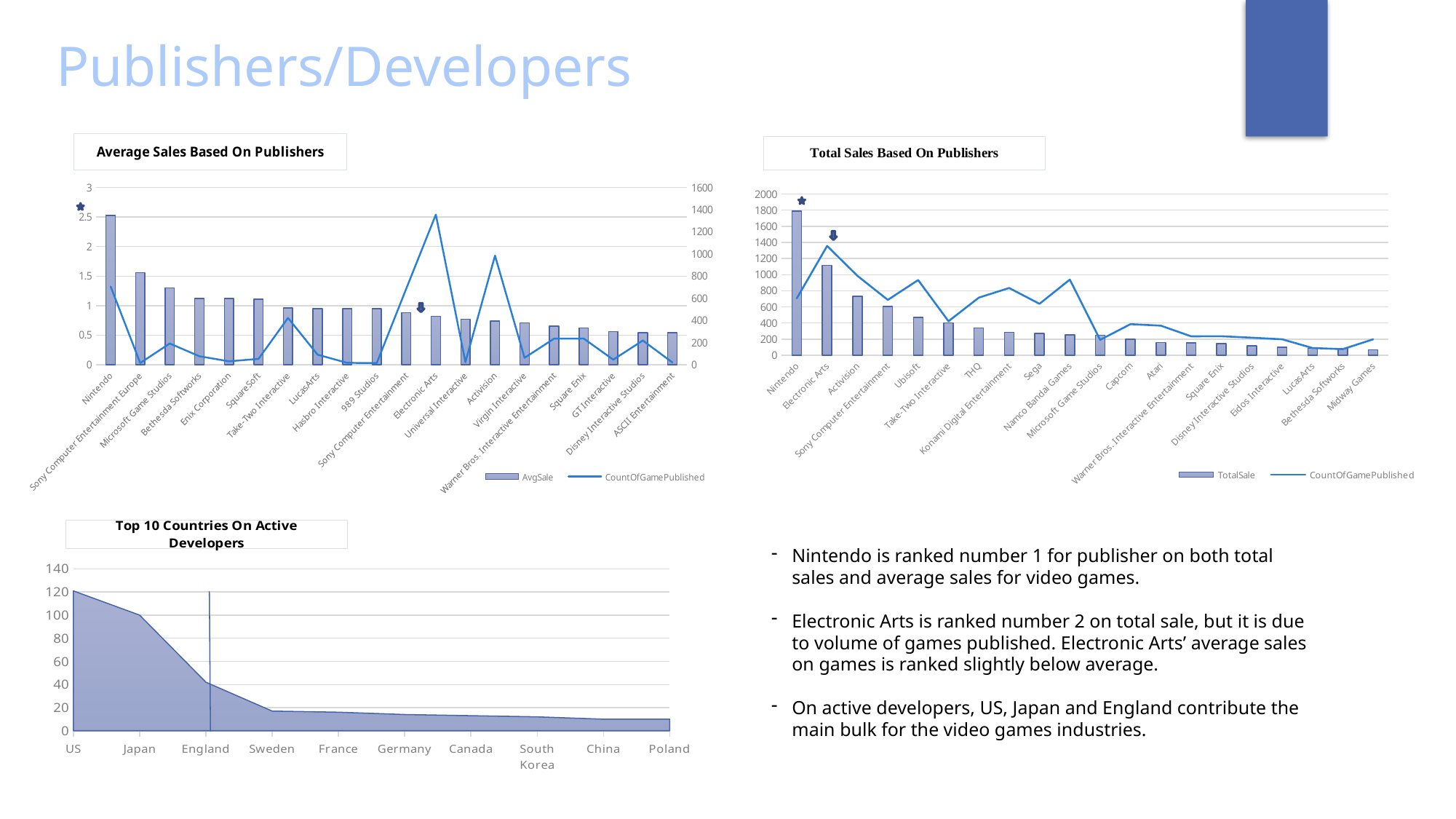
In the 'Total Sales Based On Publishers' chart, which has the larger TotalSale bar, Nintendo or Electronic Arts? Nintendo In the 'Top 10 Countries On Active Developers' chart, is the value for Germany greater or less than 40? less How many series does the legend of the 'Average Sales Based On Publishers' chart list? 2 In the 'Top 10 Countries On Active Developers' chart, is the value for US greater or less than 100? greater In the 'Average Sales Based On Publishers' chart, which publisher has the highest CountOfGamePublished value? Electronic Arts In the 'Top 10 Countries On Active Developers' chart, do the values rise or fall from US to Poland? Fall In the 'Top 10 Countries On Active Developers' chart, which country has the highest value? US In the 'Top 10 Countries On Active Developers' chart, which country has the lowest value? China and Poland (tied) What kind of chart is the 'Top 10 Countries On Active Developers' chart? Area chart In the 'Average Sales Based On Publishers' chart, which publisher has the highest AvgSale bar? Nintendo In the 'Total Sales Based On Publishers' chart, is the TotalSale value for Nintendo greater or less than 1600? greater How many countries are shown in the 'Top 10 Countries On Active Developers' chart? 10